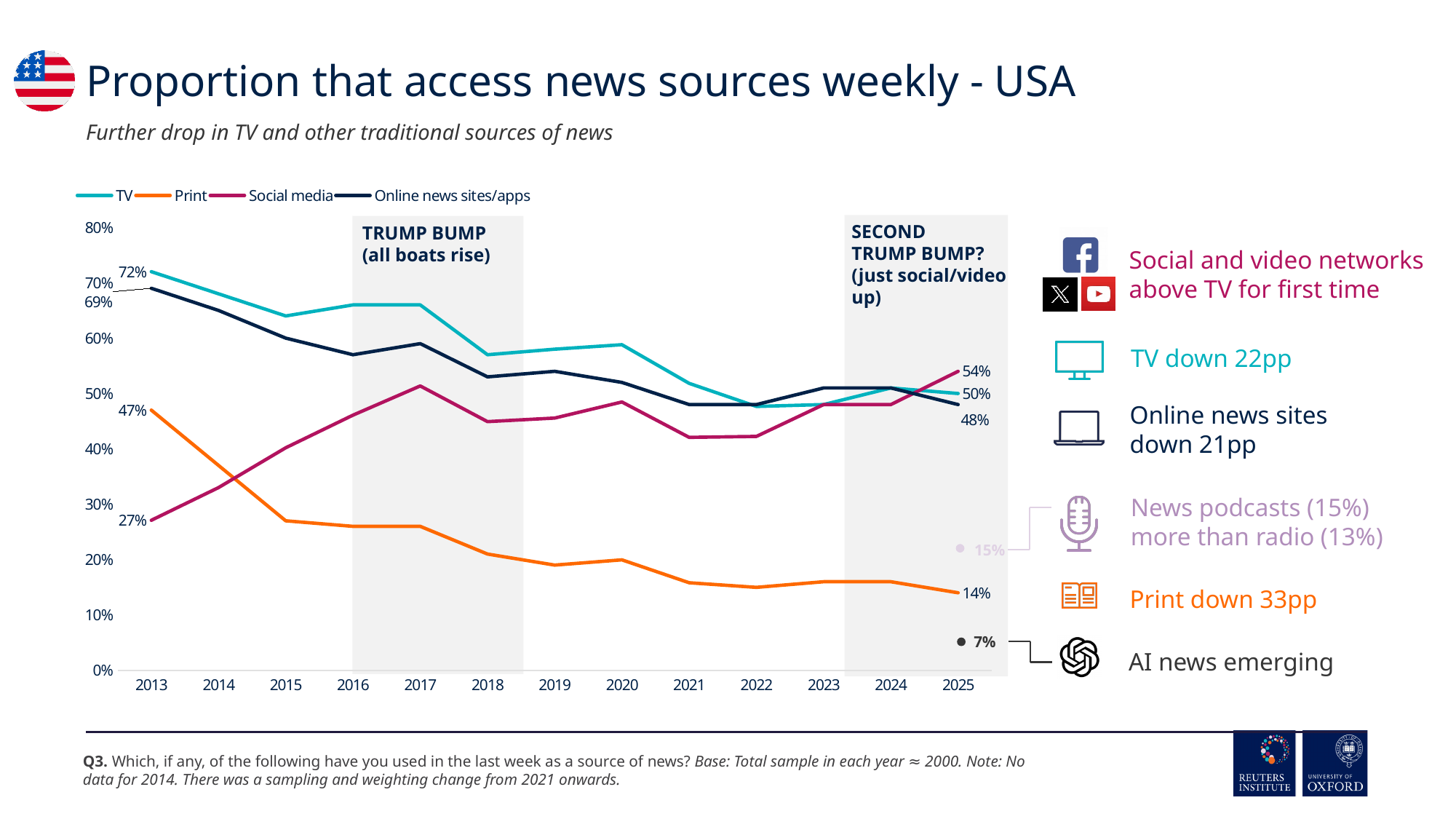
How many series does the chart legend list? 4 By how many percentage points did TV fall between 2013 (72%) and 2025 (50%)? 22 percentage points What was the value for Social media in 2025? 54% Is the value for TV in 2017 greater or less than 60%? greater What was the value for Online news sites/apps in 2013? 69% Which news source had the highest value in 2025? Social media Does the Print line rise or fall from 2013 to 2025? fall What was the value for Print in 2025? 14% What kind of chart is shown on the slide? line chart What was the value for TV in 2013? 72% Which news source had the lowest value in 2013? Social media By how many percentage points did Print fall between 2013 (47%) and 2025 (14%)? 33 percentage points